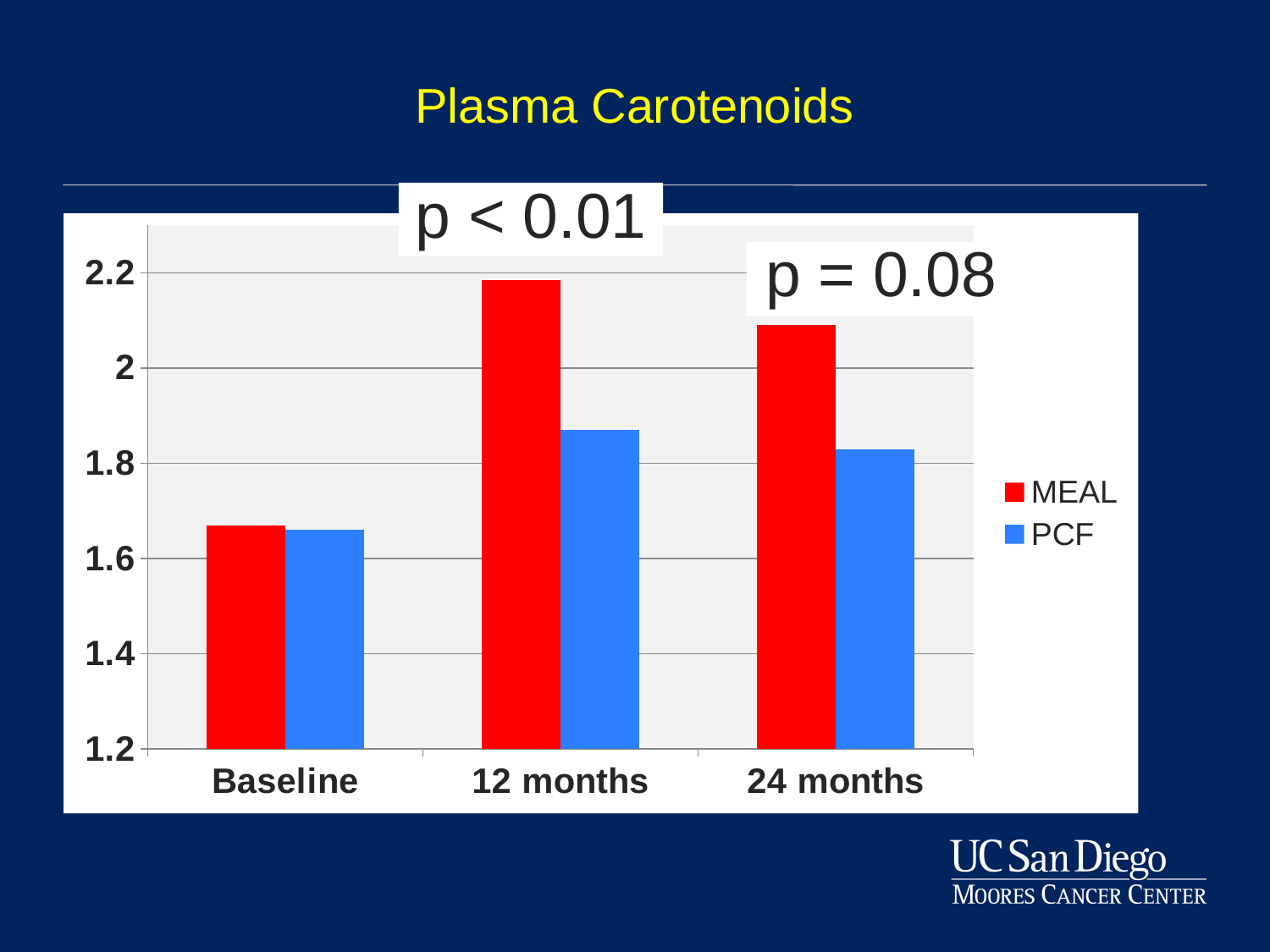
What is the title of the slide? Plasma Carotenoids How many categories are shown on the x axis? 3 At 12 months, which series has the larger value, MEAL or PCF? MEAL At which time point is the PCF value lowest? Baseline Does the MEAL value rise or fall from Baseline to 12 months? rise Which series is shown in red? MEAL What kind of chart is shown on the slide? bar chart Is the PCF value at 12 months greater or less than 2? less How many series does the legend list? 2 At 24 months, which series has the larger value, MEAL or PCF? MEAL Is the MEAL value at 12 months greater or less than 2? greater At which time point is the MEAL value highest? 12 months